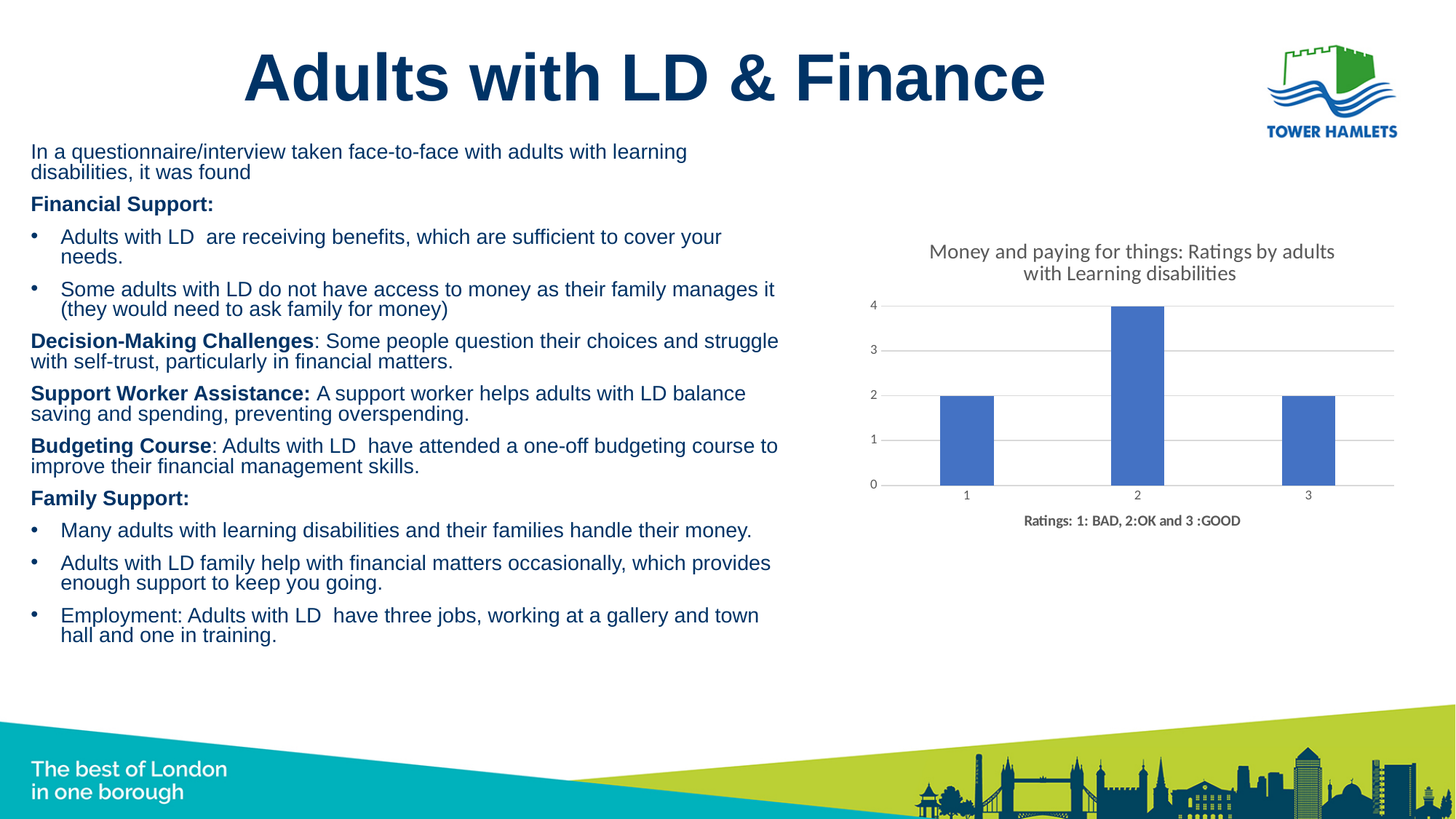
Is the value for rating 2 greater or less than 3? greater What is the value for rating 1 in the chart? 2 What is the title of the chart? Money and paying for things: Ratings by adults with Learning disabilities How many rating categories are plotted on the x axis of the chart? 3 What type of chart is shown on the slide? bar chart Which has the larger value, rating 1 or rating 2? rating 2 What is the value for rating 2 in the chart? 4 What is the difference between the value for rating 2 and the value for rating 1? 2 What is the value for rating 3 in the chart? 2 Is the value for rating 3 greater or less than 3? less Which rating has the highest value in the chart? 2 According to the x-axis label, what does a rating of 3 mean? GOOD